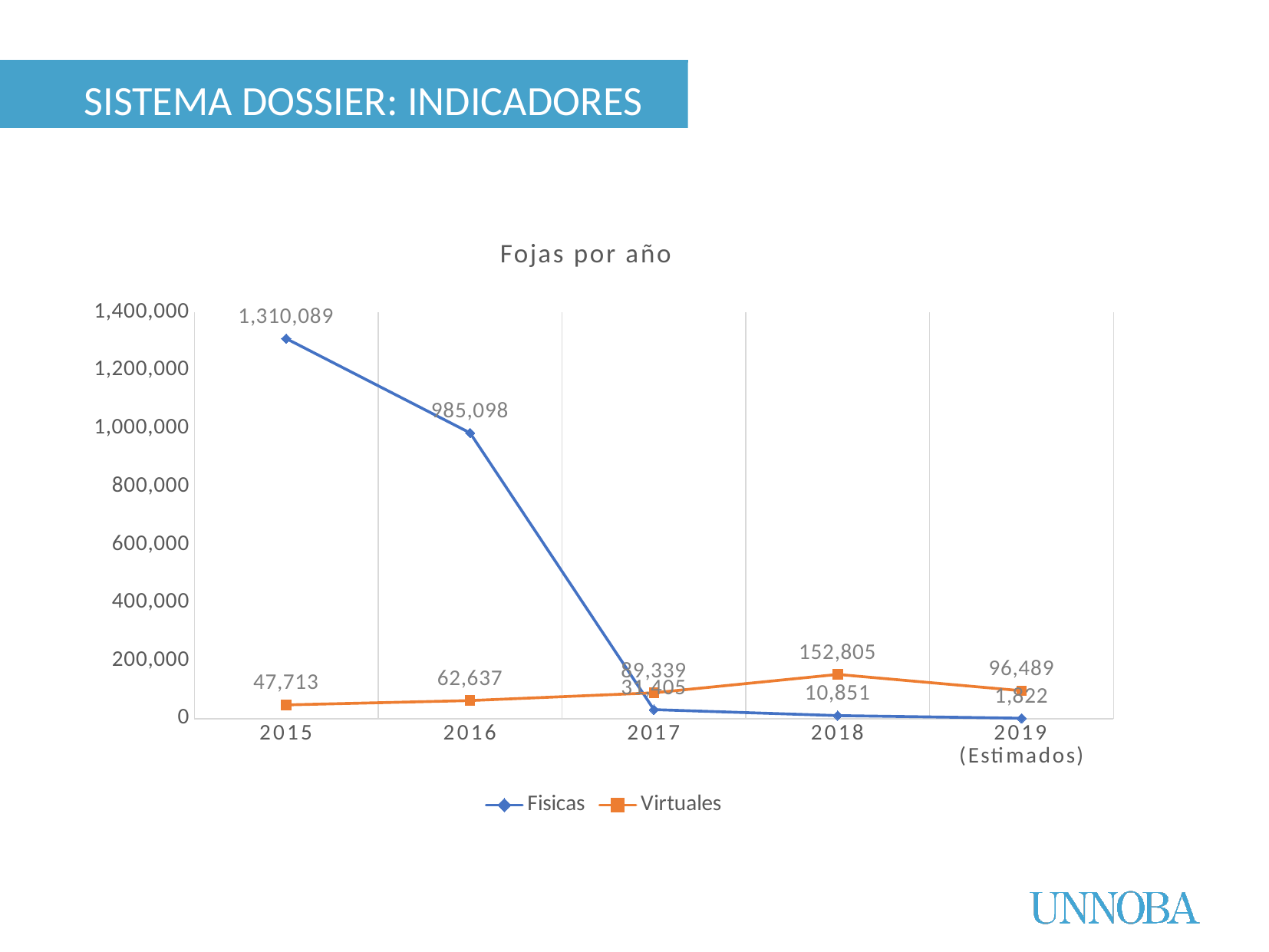
How many years are plotted along the x axis? 5 In which year is the Fisicas series lowest? 2019 (Estimados) What kind of chart is shown on the slide? line chart What is the value for Virtuales in 2016? 62,637 What is the difference between the Fisicas values for 2015 and 2016? 324,991 How many series does the legend list? 2 In which year is the Virtuales series highest? 2018 What is the value for Virtuales in 2018? 152,805 What is the value for Fisicas in 2019 (Estimados)? 1,822 What is the value for Fisicas in 2015? 1,310,089 In 2018, which series has the larger value, Fisicas or Virtuales? Virtuales What is the title of the chart? Fojas por año